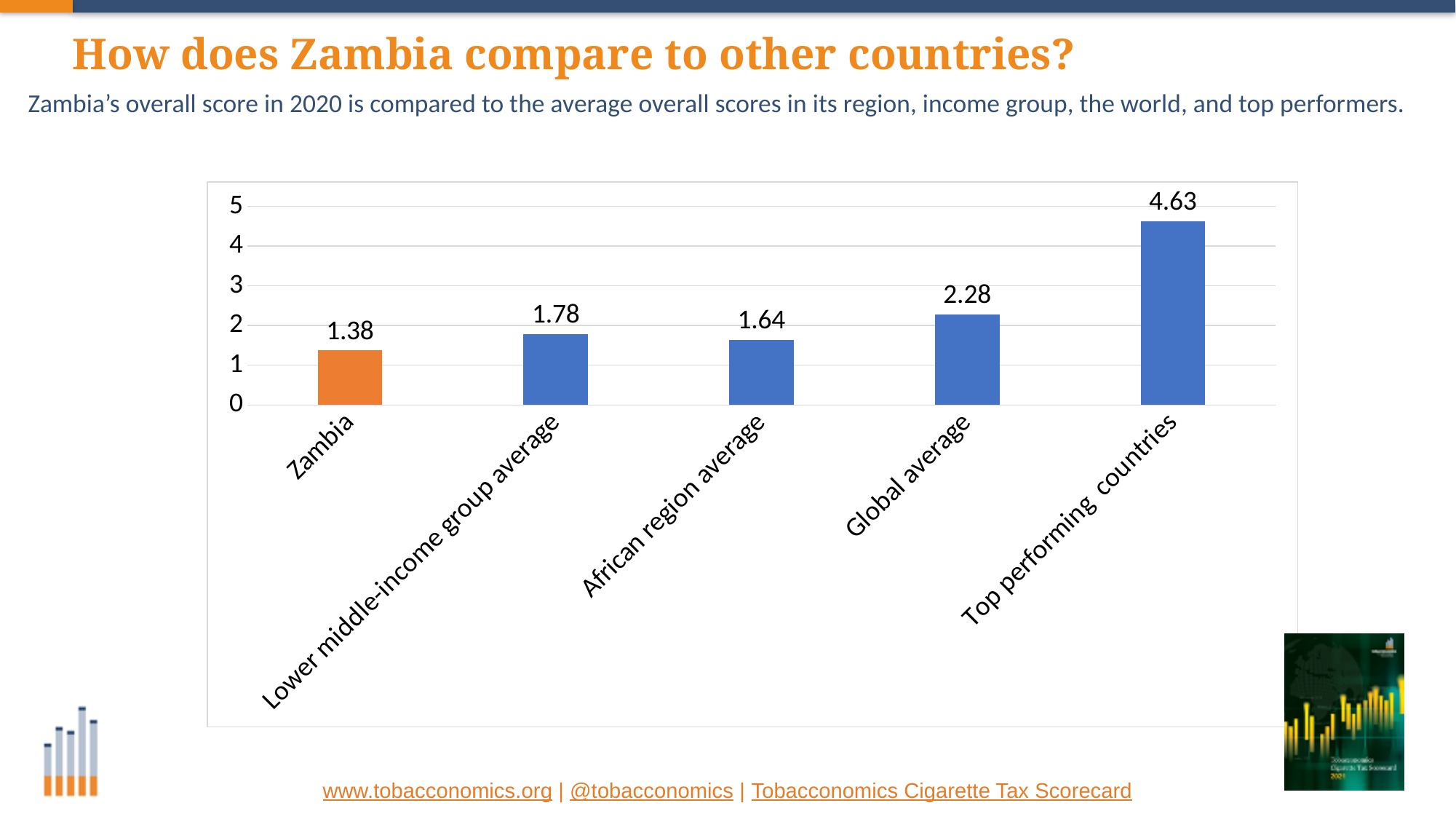
What is the value for Lower middle-income group average? 1.78 What kind of chart is shown on the slide? Bar chart Which category has the lowest value? Zambia Which is larger, the value for Lower middle-income group average or the value for African region average? Lower middle-income group average Which category has the highest value? Top performing countries What is the value for Top performing countries? 4.63 What is the difference between the value for Top performing countries and the value for Zambia? 3.25 How many categories are shown on the chart? 5 What is the difference between the Global average and the African region average? 0.64 What is the value for African region average? 1.64 What is the value for Zambia? 1.38 What is the value for Global average? 2.28